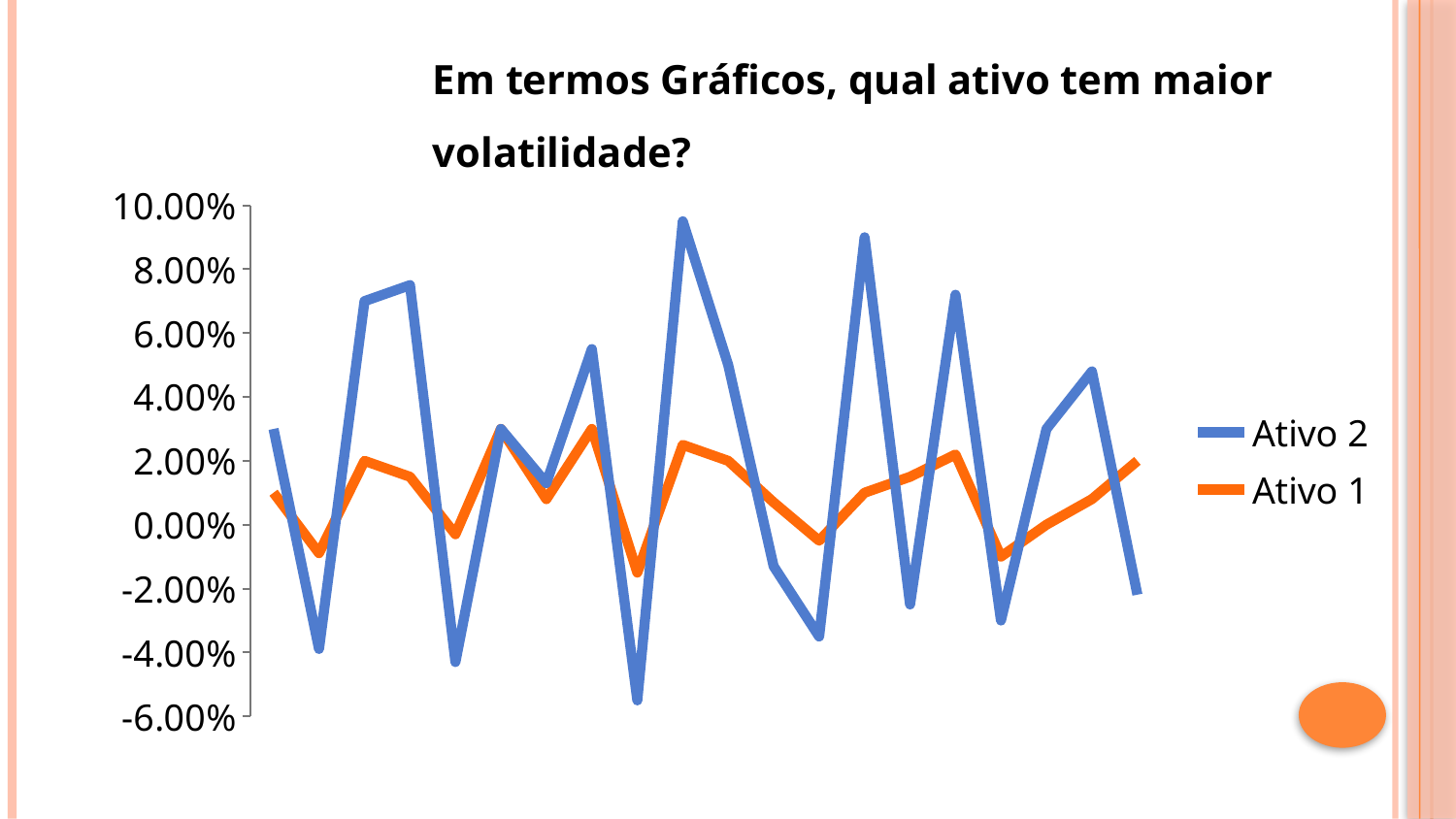
What are the two series named in the legend? Ativo 2 and Ativo 1 Is the lowest value of Ativo 2 greater or less than -4.00%? less Which series shows greater volatility, Ativo 1 or Ativo 2? Ativo 2 Which series reaches the lowest value on the chart? Ativo 2 Is the highest value of Ativo 2 greater or less than 8.00%? greater What kind of chart is shown on the slide? Line chart Does Ativo 1 ever exceed 6.00% on the chart? No Which series reaches the highest value on the chart? Ativo 2 Which series is drawn in orange? Ativo 1 How many series does the legend list? 2